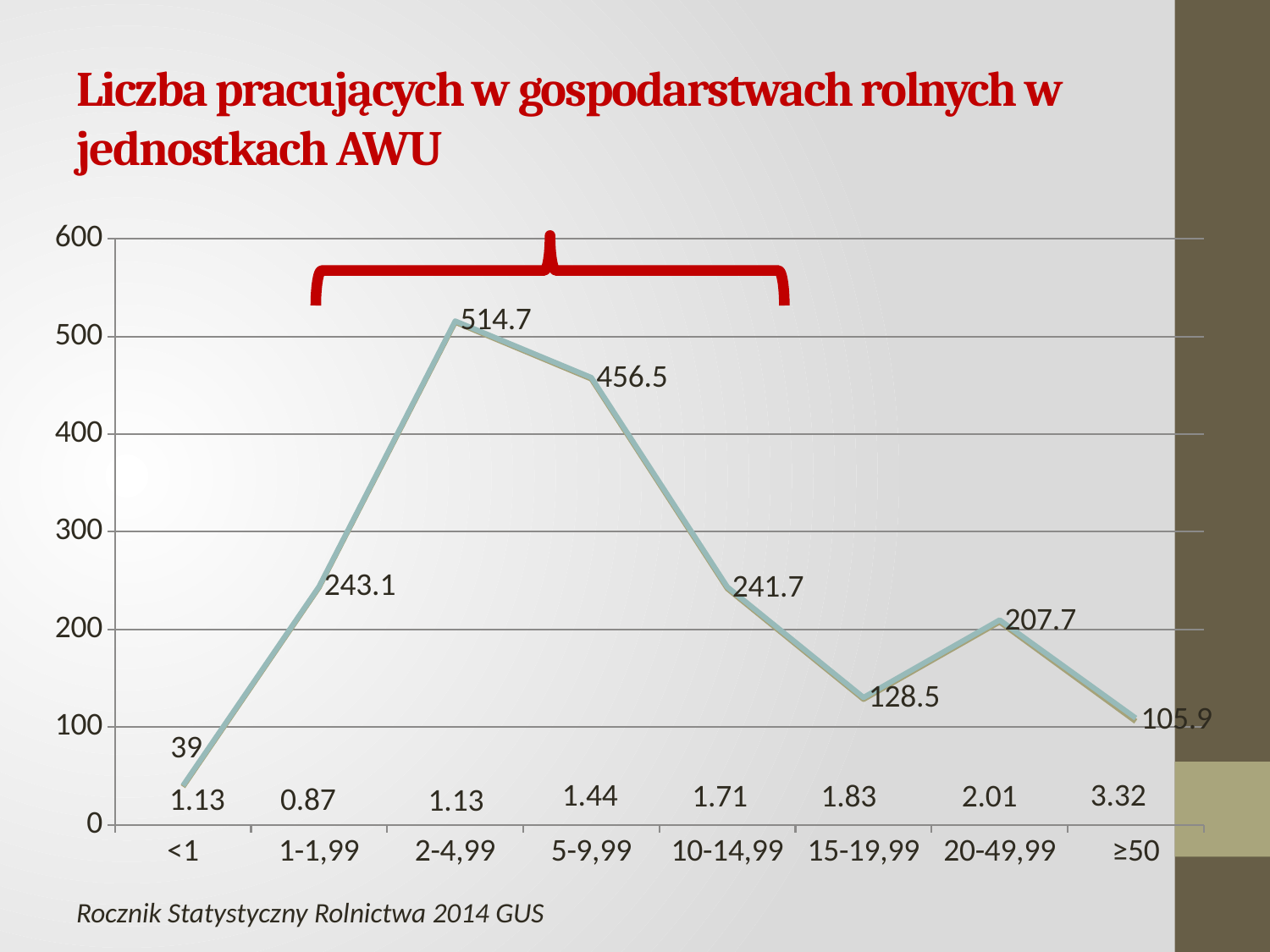
What is the difference between the values for 2-4,99 and 5-9,99? 58.2 What is the value for the ≥50 category? 105.9 What is the value for the 15-19,99 category? 128.5 What type of chart is shown on the slide? line chart How many categories are shown on the x axis? 8 What is the value for the 2-4,99 category? 514.7 Which category has the highest value? 2-4,99 Do the values rise or fall from 10-14,99 to 15-19,99? fall Which category has the lowest value? <1 What is the title of the chart? Liczba pracujących w gospodarstwach rolnych w jednostkach AWU Which is larger, the value for 10-14,99 or the value for 20-49,99? 10-14,99 What is the value for the <1 category? 39